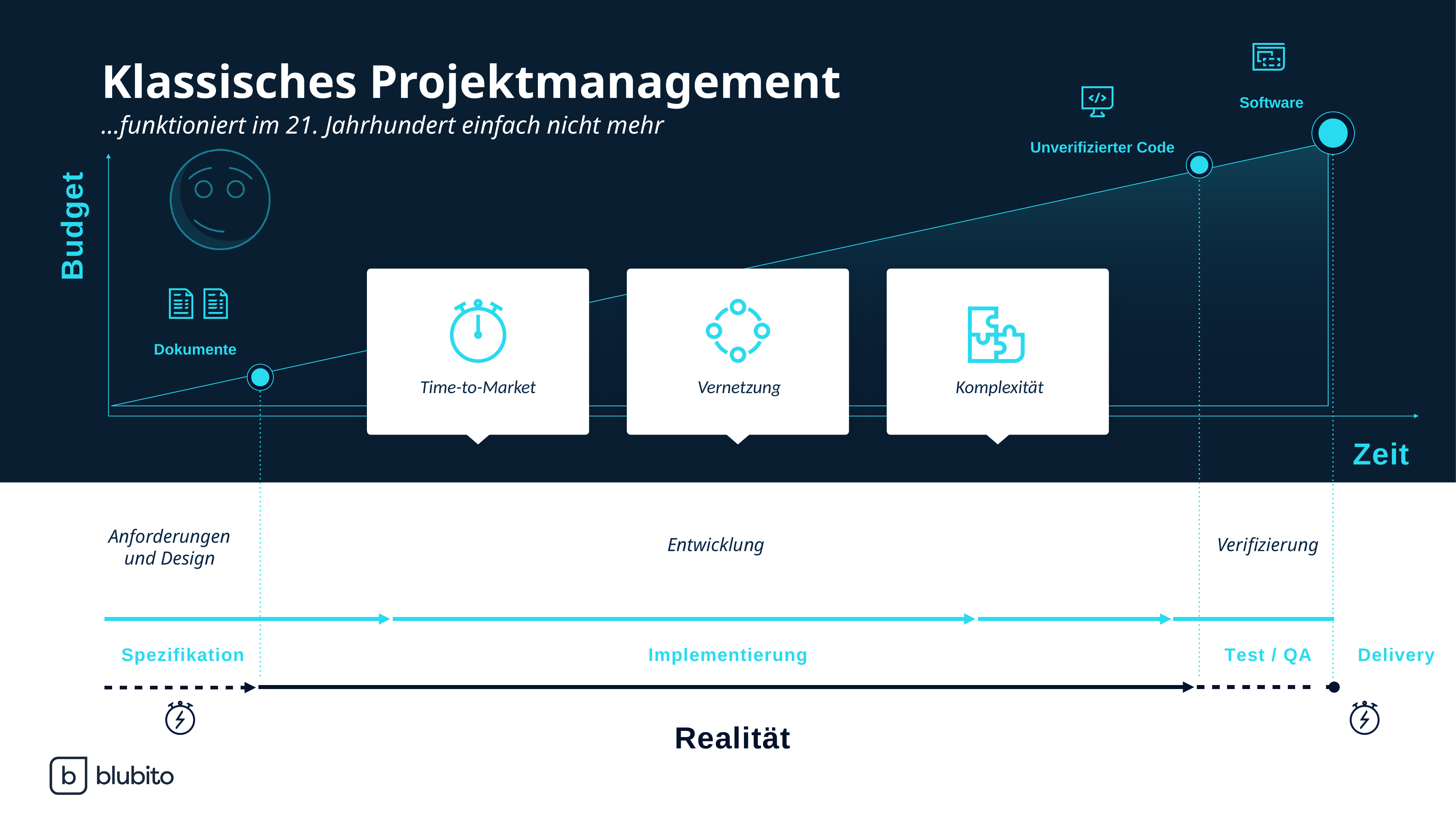
Which point is higher on the Budget axis, Software or Unverifizierter Code? Software Which point is higher on the Budget axis, Unverifizierter Code or Dokumente? Unverifizierter Code What kind of chart is shown on the slide? area chart Which labelled point on the line has the highest budget value? Software Which labelled point appears last along the Zeit axis? Software What is the label of the horizontal axis of the chart? Zeit Does the plotted line rise or fall along the x axis? rise How many labelled points are marked on the plotted line? 3 Which labelled point appears first along the Zeit axis? Dokumente Which labelled point on the line has the lowest budget value? Dokumente What is the label of the vertical axis of the chart? Budget